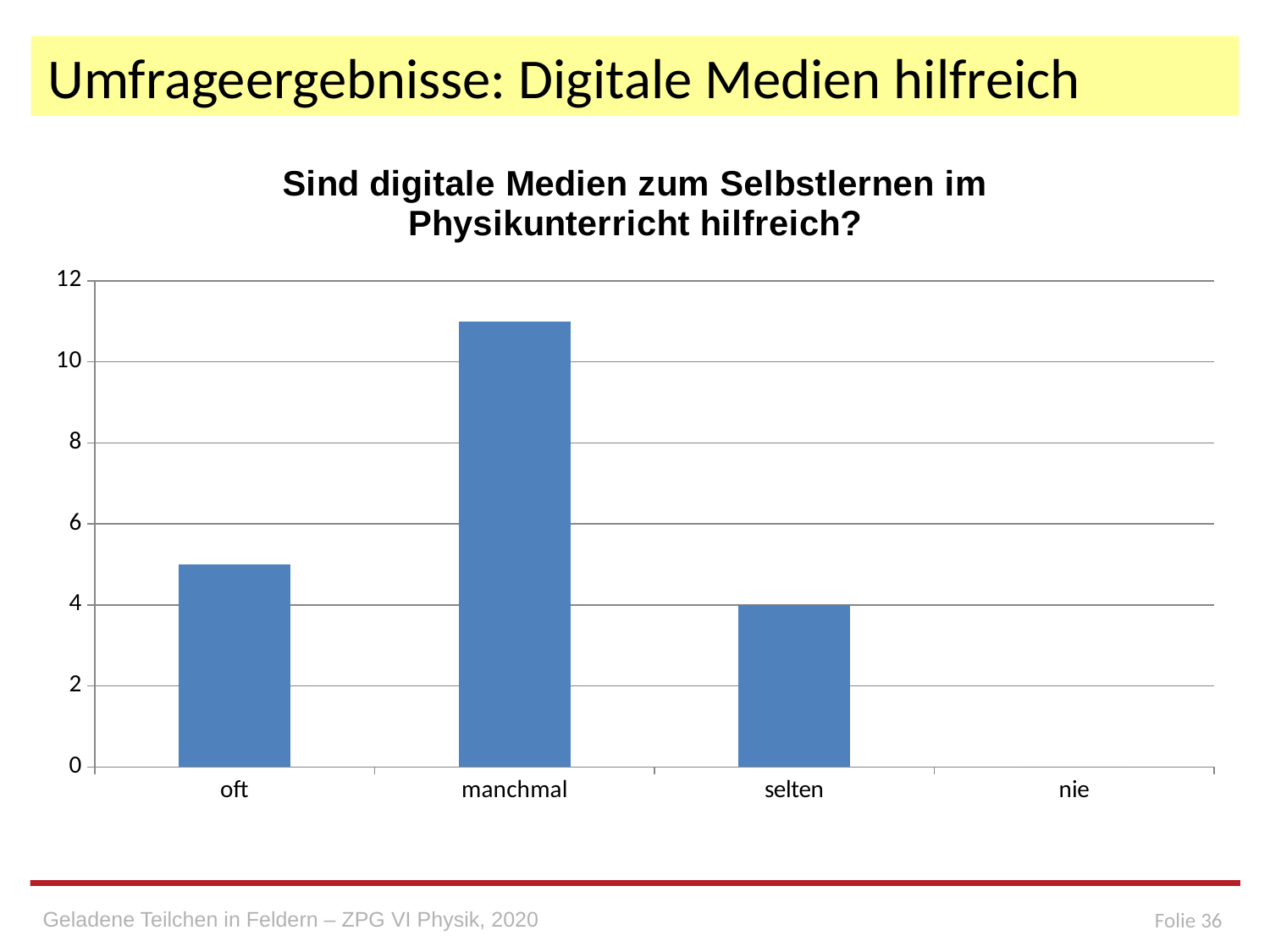
What is the value for "selten"? 4 What kind of chart is shown on the slide? bar chart Is the value for "oft" greater or less than 6? less Is the value for "manchmal" greater or less than 10? greater What is the value for "nie"? 0 Is the value for "oft" greater or less than 4? greater Which category has the highest value? manchmal Which is larger, the value for "oft" or the value for "selten"? oft How many categories are shown on the x axis of the chart? 4 Which category has the lowest value? nie What is the title of the chart? Sind digitale Medien zum Selbstlernen im Physikunterricht hilfreich? Which is larger, the value for "manchmal" or the value for "oft"? manchmal